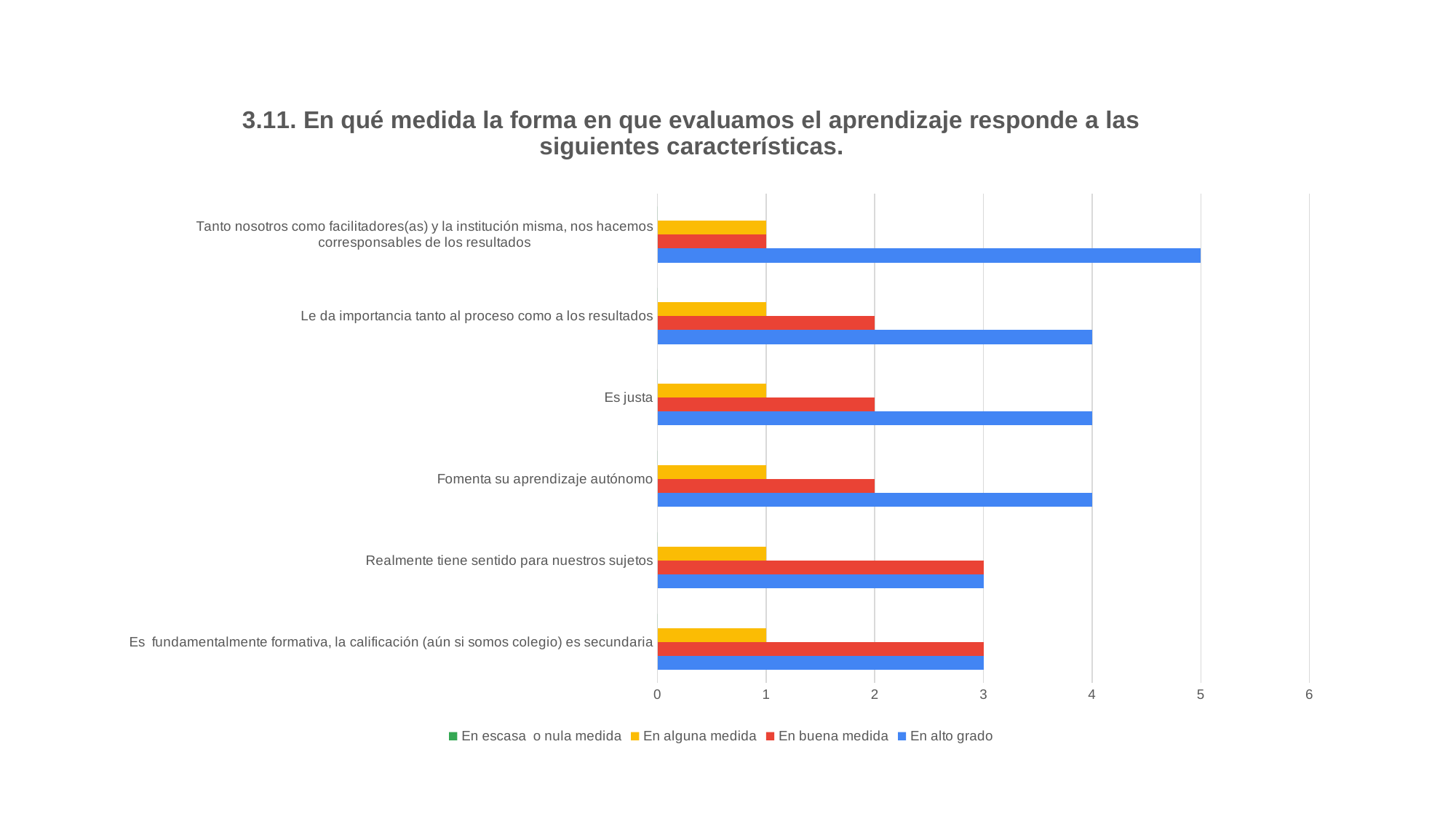
How many categories are plotted on the chart? 6 Is the 'En alto grado' value for 'Es fundamentalmente formativa, la calificación (aún si somos colegio) es secundaria' greater or less than 4? less What is the difference between the 'En alto grado' value and the 'En buena medida' value for 'Fomenta su aprendizaje autónomo'? 2 What is the value of 'En buena medida' for 'Realmente tiene sentido para nuestros sujetos'? 3 For 'Es justa', which is larger: the 'En alto grado' value or the 'En buena medida' value? En alto grado What is the value of 'En buena medida' for 'Le da importancia tanto al proceso como a los resultados'? 2 Which category has the highest value for 'En alto grado'? Tanto nosotros como facilitadores(as) y la institución misma, nos hacemos corresponsables de los resultados What is the value of 'En alto grado' for 'Tanto nosotros como facilitadores(as) y la institución misma, nos hacemos corresponsables de los resultados'? 5 How many series does the legend list? 4 What kind of chart is shown on the slide? Bar chart Which legend entry is shown in blue? En alto grado What is the value of 'En alguna medida' for 'Es justa'? 1